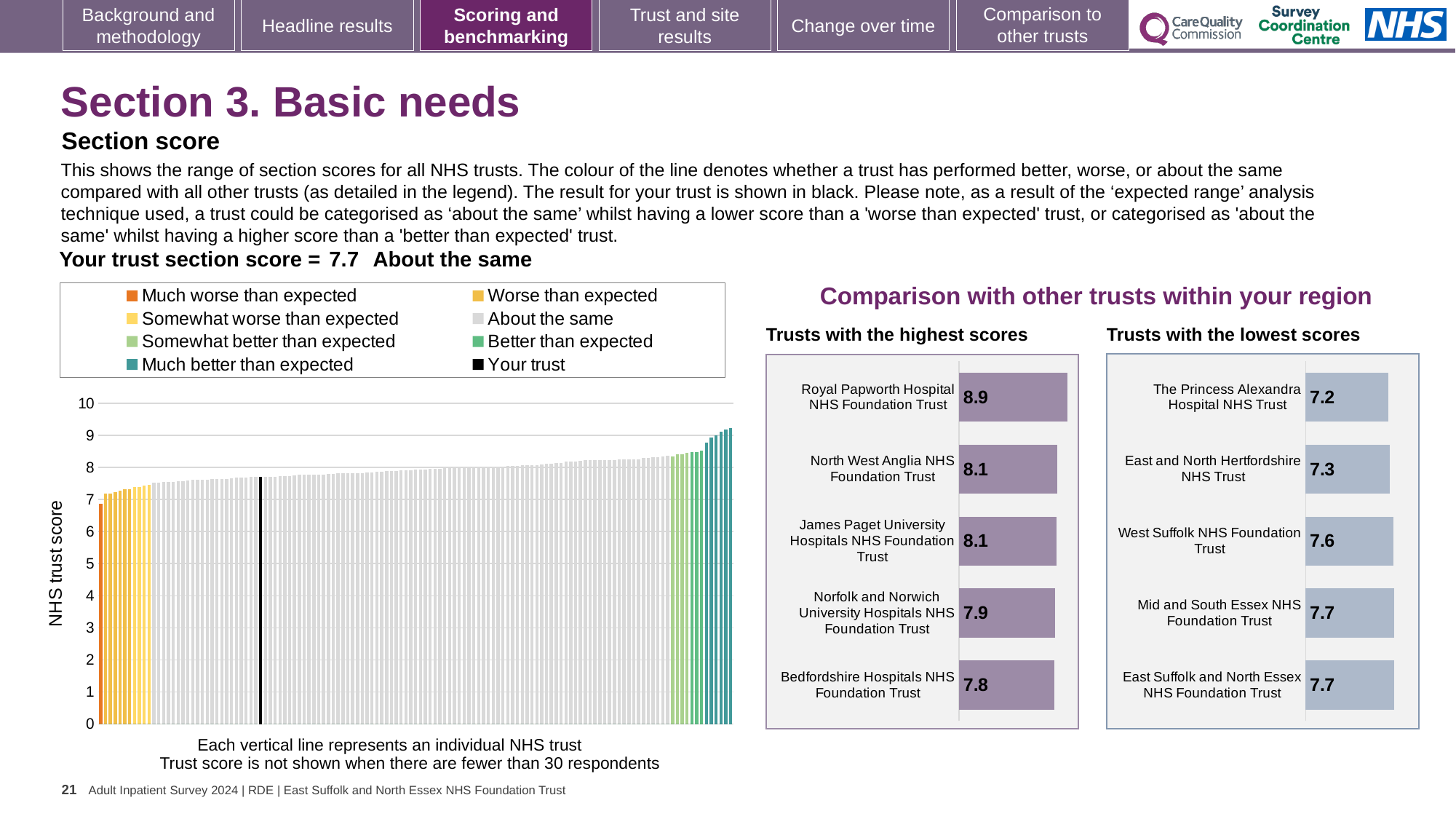
In the 'Trusts with the lowest scores' chart, what is the score for The Princess Alexandra Hospital NHS Trust? 7.2 What kind of chart is the main chart on the left showing NHS trust scores? Bar chart In the 'Trusts with the lowest scores' chart, which has the larger score: West Suffolk NHS Foundation Trust or East and North Hertfordshire NHS Trust? West Suffolk NHS Foundation Trust How many trusts are shown in the 'Trusts with the highest scores' chart? 5 In the 'Trusts with the lowest scores' chart, which trust has the lowest score? The Princess Alexandra Hospital NHS Trust In the 'Trusts with the highest scores' chart, what is the score for Royal Papworth Hospital NHS Foundation Trust? 8.9 In the main chart on the left showing NHS trust scores, what is the section score for your trust? 7.7 In the main chart on the left, do the trust scores rise or fall from left to right along the x axis? Rise In the 'Trusts with the lowest scores' chart, what is the score for Mid and South Essex NHS Foundation Trust? 7.7 How many entries does the legend of the main chart on the left list? 8 In the 'Trusts with the highest scores' chart, which trust has the highest score? Royal Papworth Hospital NHS Foundation Trust In the 'Trusts with the highest scores' chart, what is the difference between the scores of Royal Papworth Hospital NHS Foundation Trust and Bedfordshire Hospitals NHS Foundation Trust? 1.1